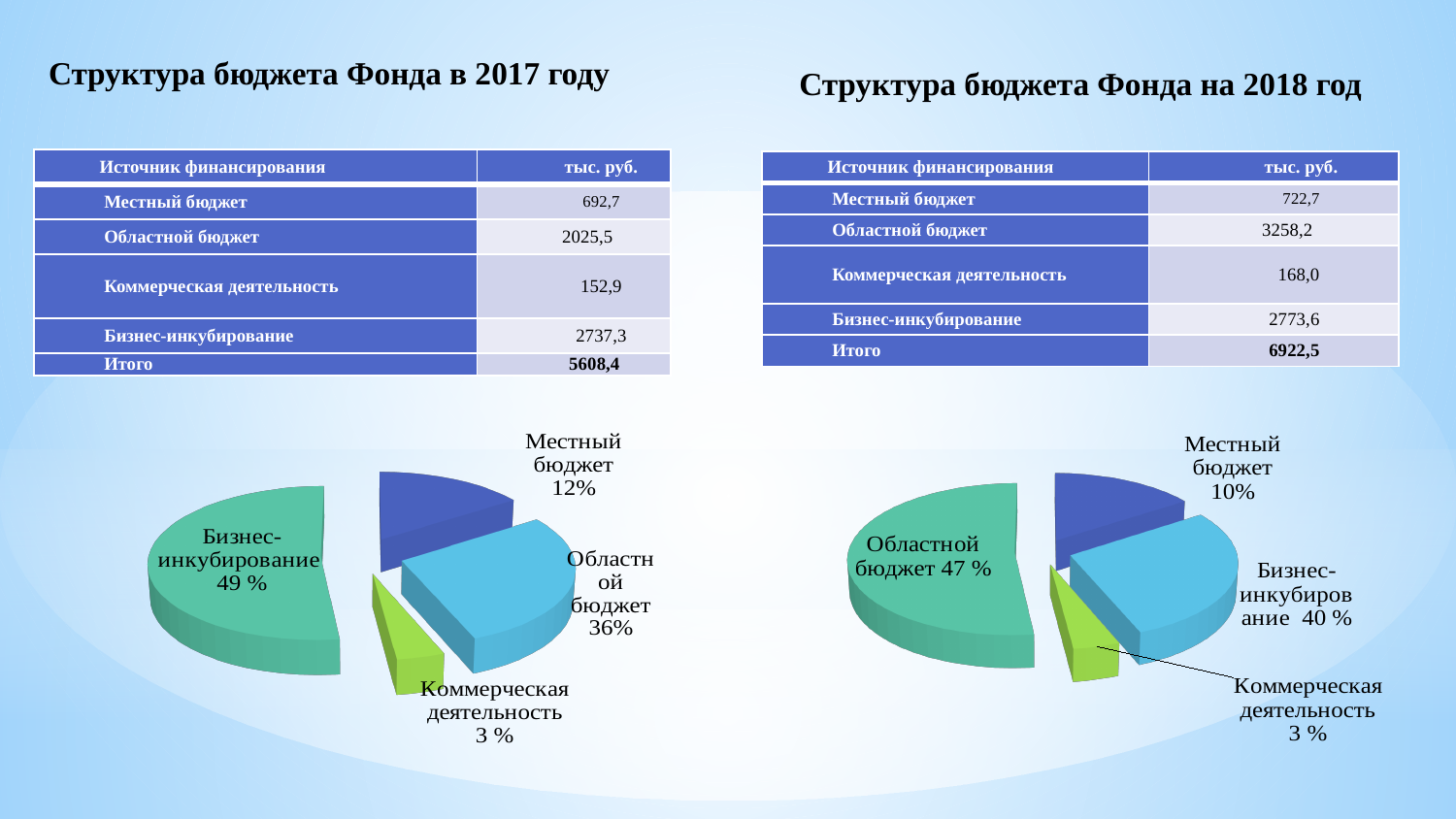
On the right pie chart (2018), what share is labelled for Областной бюджет? 47 % On the left pie chart (2017), what share is labelled for Бизнес-инкубирование? 49 % On the right pie chart (2018), which category has the smallest slice? Коммерческая деятельность On the right pie chart (2018), what share is labelled for Коммерческая деятельность? 3 % On the left pie chart (2017), which category has the largest slice? Бизнес-инкубирование On the right pie chart (2018), which is larger: Областной бюджет or Бизнес-инкубирование? Областной бюджет What type of chart is shown on the left side of the slide? Pie chart How many slices does the right pie chart (2018) have? 4 On the left pie chart (2017), what is the difference in percentage points between Бизнес-инкубирование and Областной бюджет? 13